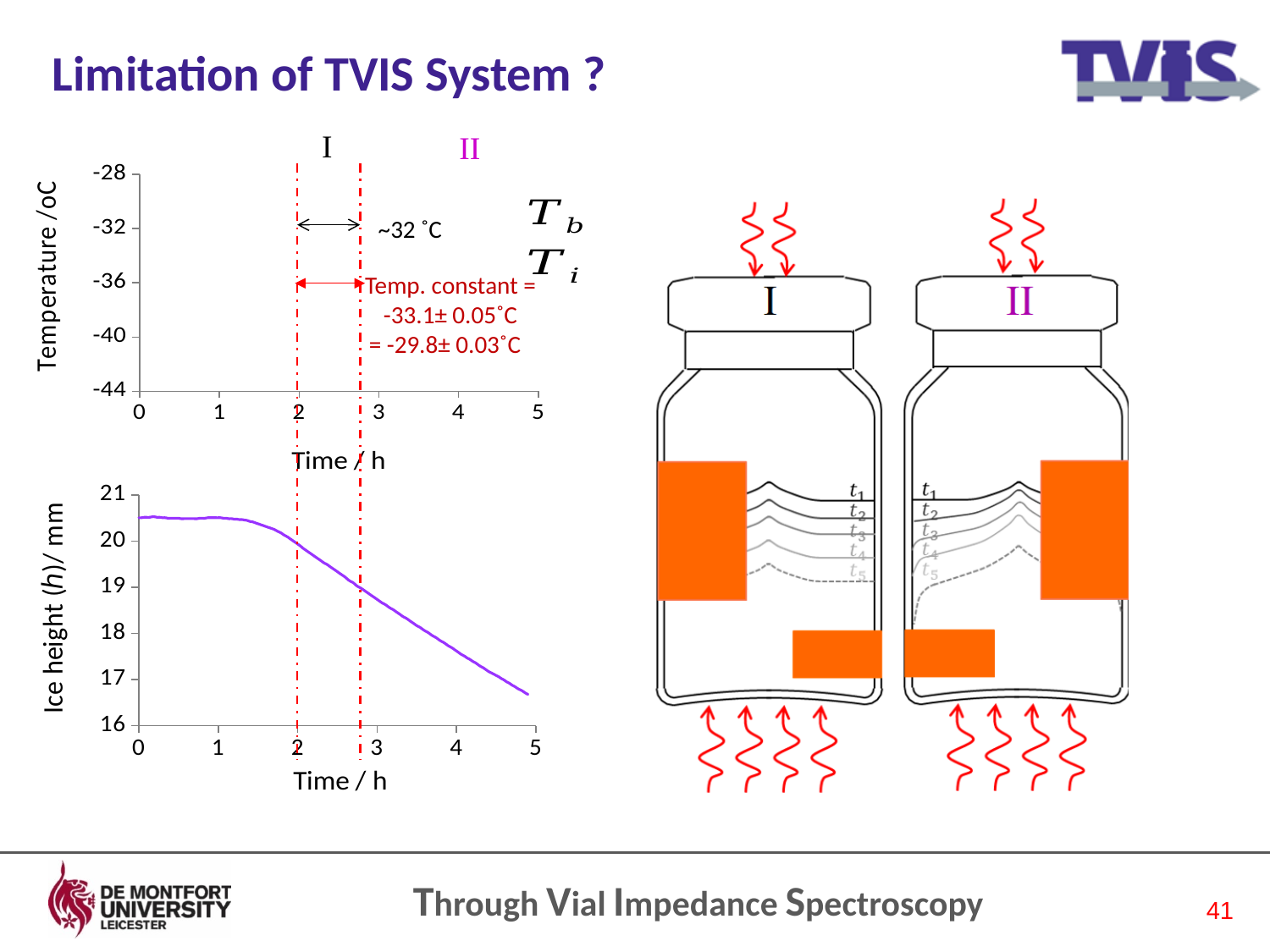
What is the y-axis label of the top chart? Temperature /oC In the bottom chart (Ice height vs Time), does the ice height rise or fall as time increases? fall What is the x-axis label of the bottom chart (Ice height vs Time)? Time / h In the bottom chart (Ice height vs Time), is the ice height at the end of the curve (near 5 h) greater or less than 17 mm? less How many data series are plotted in the bottom chart (Ice height vs Time)? 1 In the top chart (Temperature vs Time), what is the lowest value shown on the y axis? -44 In the bottom chart (Ice height vs Time), what is the highest value shown on the y axis? 21 In the bottom chart (Ice height vs Time), is the ice height at 1 h greater or less than 20 mm? greater In the bottom chart (Ice height vs Time), is the ice height higher at 1 h or at 4 h? 1 h In the bottom chart (Ice height vs Time), is the ice height at 4 h greater or less than 19 mm? less What kind of chart is the bottom chart (Ice height vs Time)? line chart